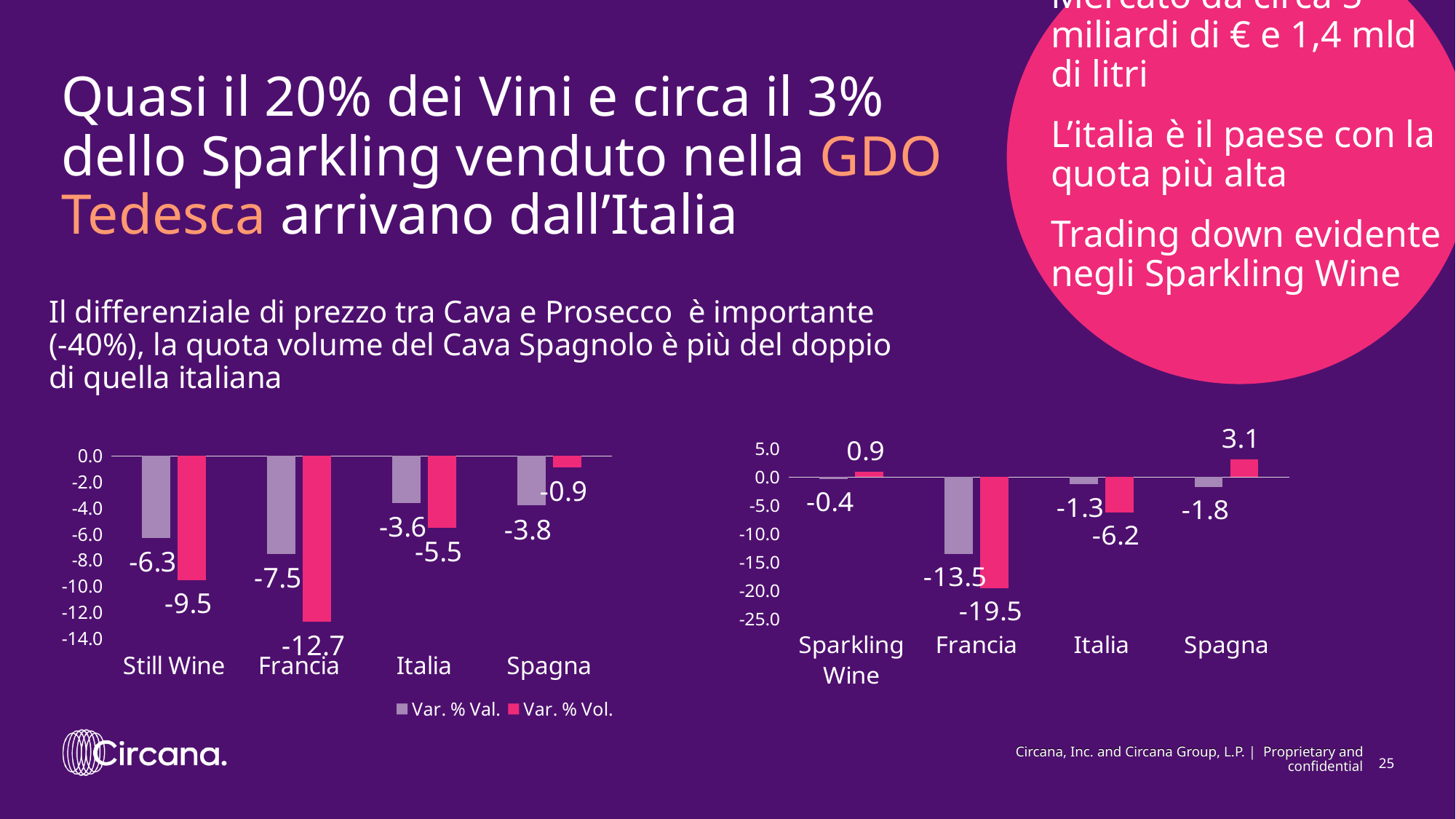
In the right chart, what is the difference between the Var. % Vol. values for Spagna and Italia? 9.3 In the right chart, is the Var. % Vol. value for Sparkling Wine larger or smaller than the Var. % Vol. value for Italia? larger In the right chart, what is the Var. % Val. value for Francia? -13.5 In the left chart, what is the Var. % Vol. value for Francia? -12.7 In the right chart, which category has the lowest Var. % Vol. value? Francia How many series does the legend list? 2 In the left chart, what is the difference between the Var. % Val. and Var. % Vol. values for Italia? 1.9 In the left chart, what is the Var. % Val. value for Still Wine? -6.3 In the right chart, what is the Var. % Vol. value for Spagna? 3.1 What type of chart is the right chart? bar chart How many categories are shown on the x axis of the left chart? 4 In the left chart, which category has the highest Var. % Vol. value? Spagna